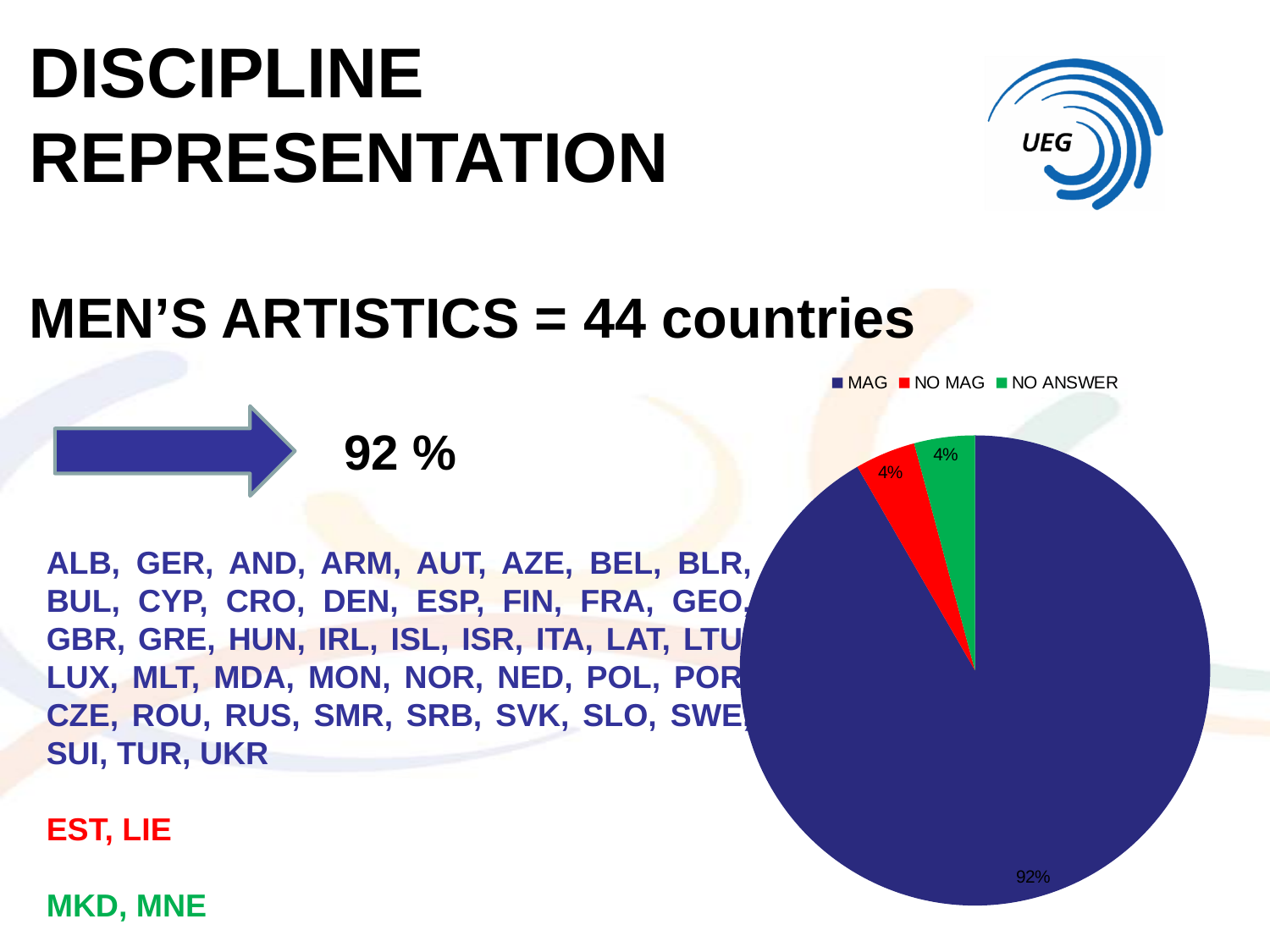
What percentage of the pie chart is NO MAG? 4% Which is larger in the pie chart, MAG or NO ANSWER? MAG What percentage of the pie chart is NO ANSWER? 4% What colour is the MAG slice in the pie chart? dark blue How many slices does the pie chart have? 3 What is the difference in percentage points between the MAG slice and the NO MAG slice? 88 What colour is the NO ANSWER slice in the pie chart? green What is the combined share of the NO MAG and NO ANSWER slices? 8% What percentage of the pie chart is MAG? 92% What kind of chart is shown on the slide? pie chart How many entries does the legend of the pie chart list? 3 Which slice of the pie chart is the largest? MAG